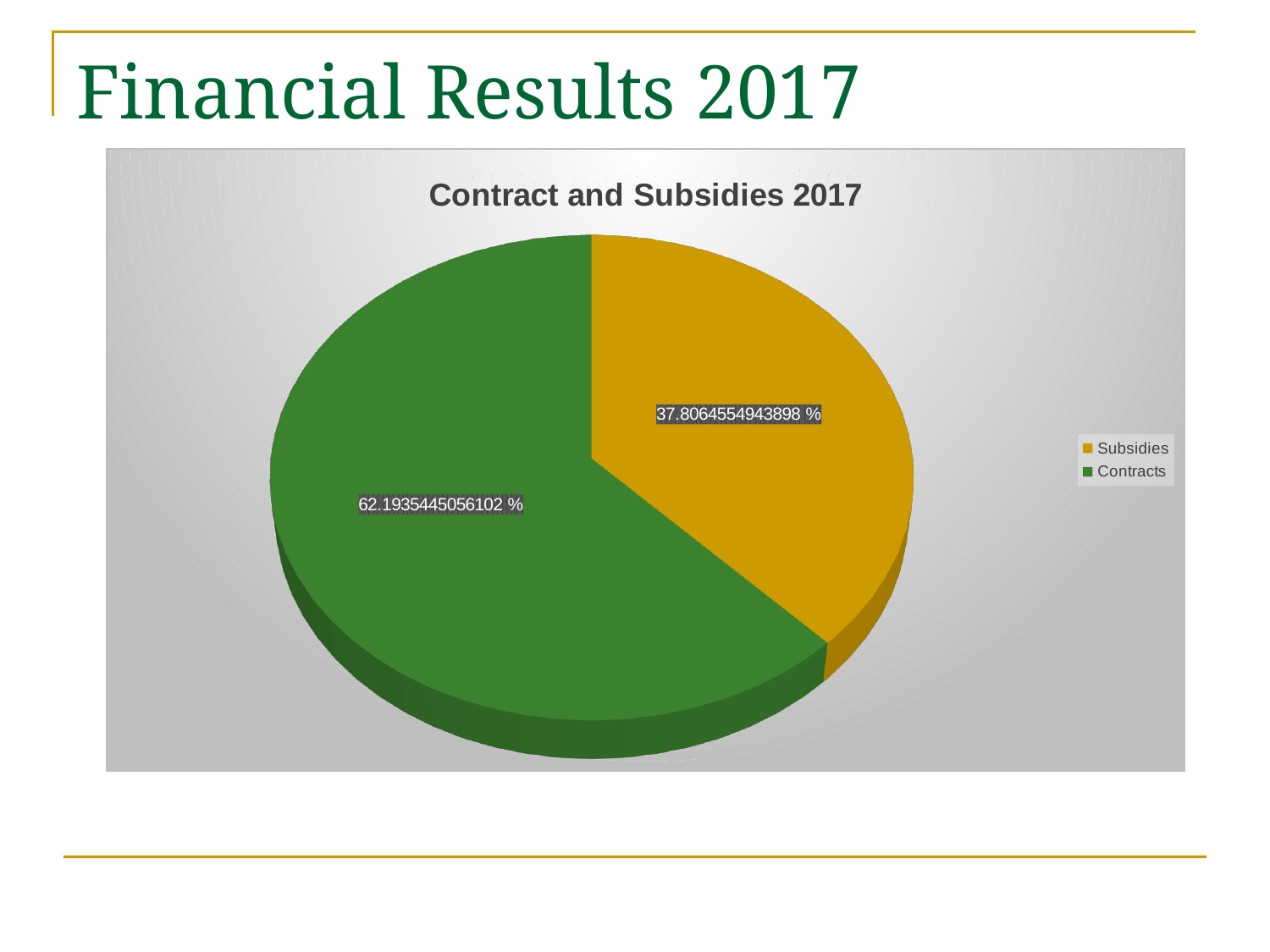
Is the share for Subsidies greater or less than 50%? less Which category has the smallest slice of the pie? Subsidies Which category has the largest slice of the pie? Contracts How many categories does the pie chart show? 2 Is the share for Contracts greater or less than 50%? greater What share of the pie does Contracts take? 62.1935445056102 % Which is larger, the Contracts slice or the Subsidies slice? Contracts How many entries does the legend list? 2 What kind of chart is shown on the slide? pie chart What is the title of the chart? Contract and Subsidies 2017 What colour is the Subsidies slice? yellow What share of the pie does Subsidies take? 37.8064554943898 %